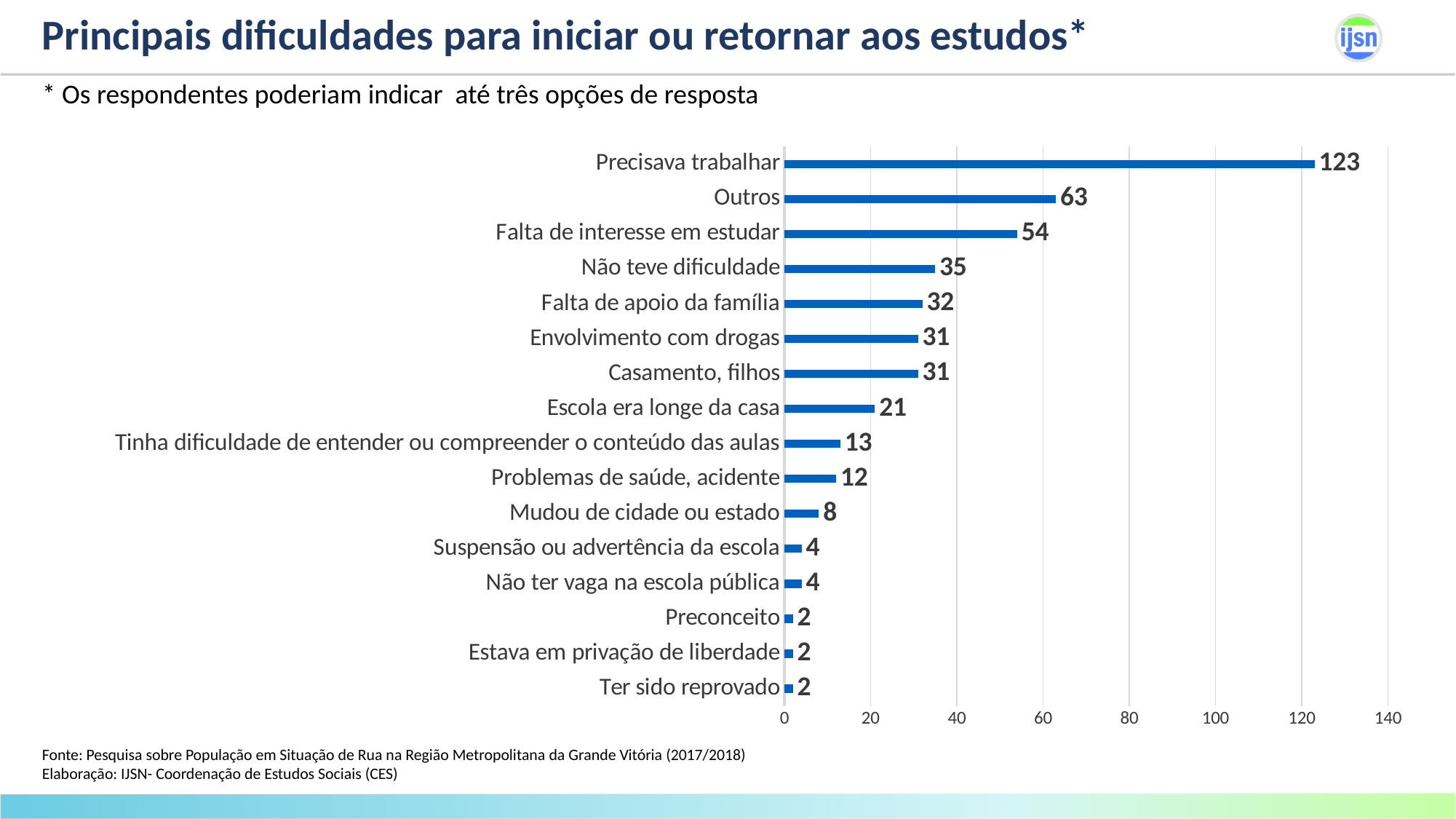
What is the difference between the values for "Não teve dificuldade" and "Falta de apoio da família"? 3 What is the value for "Precisava trabalhar"? 123 Is the value for "Precisava trabalhar" greater or less than 100? greater What is the value for "Escola era longe da casa"? 21 What is the difference between the values for "Precisava trabalhar" and "Outros"? 60 How many categories are shown in the chart? 16 Which is larger, the value for "Outros" or the value for "Falta de interesse em estudar"? Outros Which category has the highest value? Precisava trabalhar What is the value for "Mudou de cidade ou estado"? 8 What is the title of the chart on the slide? Principais dificuldades para iniciar ou retornar aos estudos* What is the value for "Falta de interesse em estudar"? 54 What kind of chart is shown on the slide? Bar chart